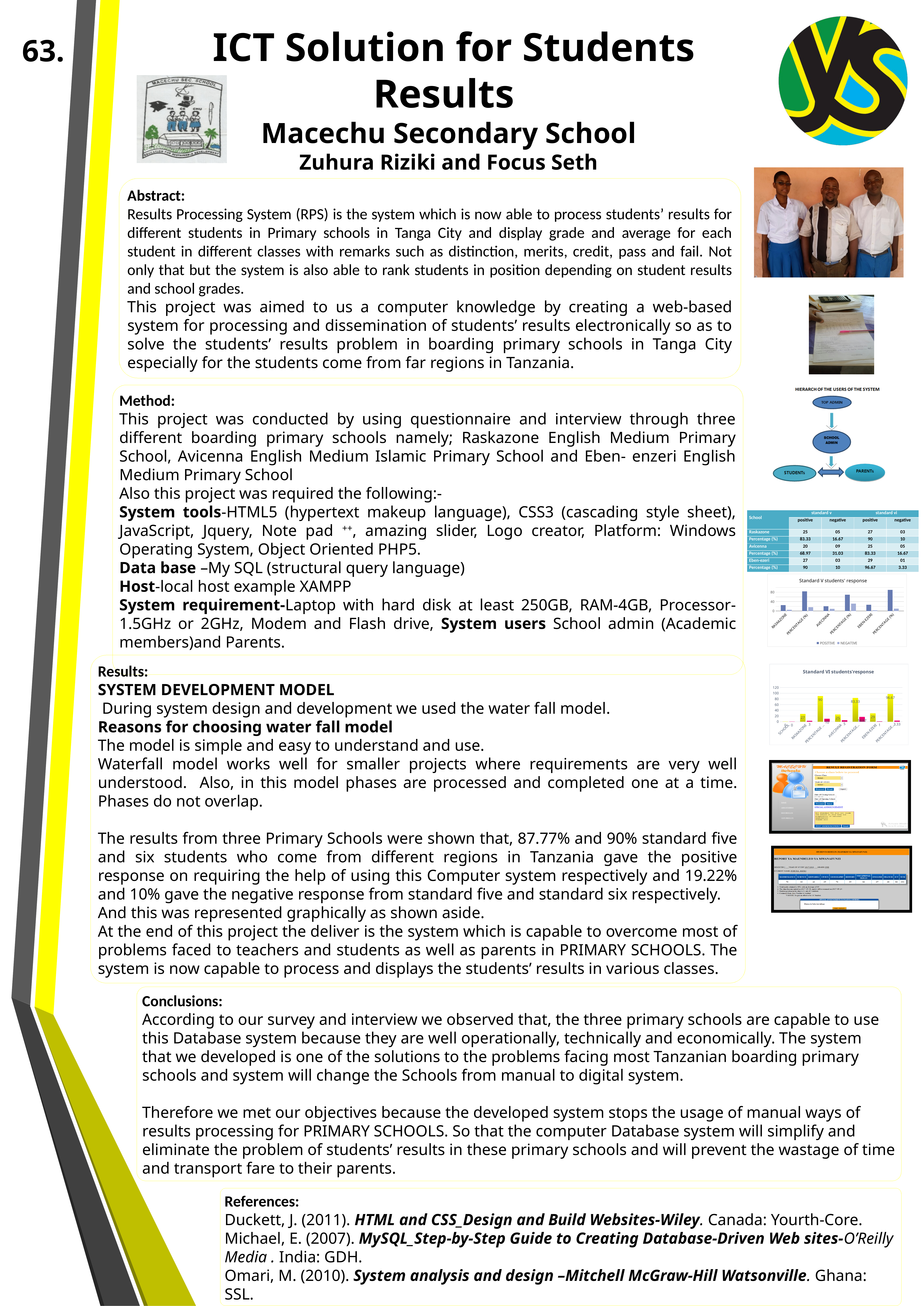
How many series does the legend of the 'Standard V students' response' chart list? 2 What are the two legend entries on the 'Standard V students' response' chart? POSITIVE and NEGATIVE What is the title of the lower chart on the right side of the slide? Standard VI students' response What is the highest value labelled on the 'Standard VI students' response' chart? 96.67 On the 'Standard VI students' response' chart, is the bar labelled 83.33 greater or less than 100? less What kind of chart is the 'Standard VI students' response' chart? bar chart On the 'Standard VI students' response' chart, what is the difference between the bars labelled 96.67 and 83.33? 13.34 On the 'Standard VI students' response' chart, which is larger, the bar labelled 90 or the bar labelled 83.33? 90 On the 'Standard VI students' response' chart, is the tallest bar greater or less than 80? greater What kind of chart is the 'Standard V students' response' chart? bar chart